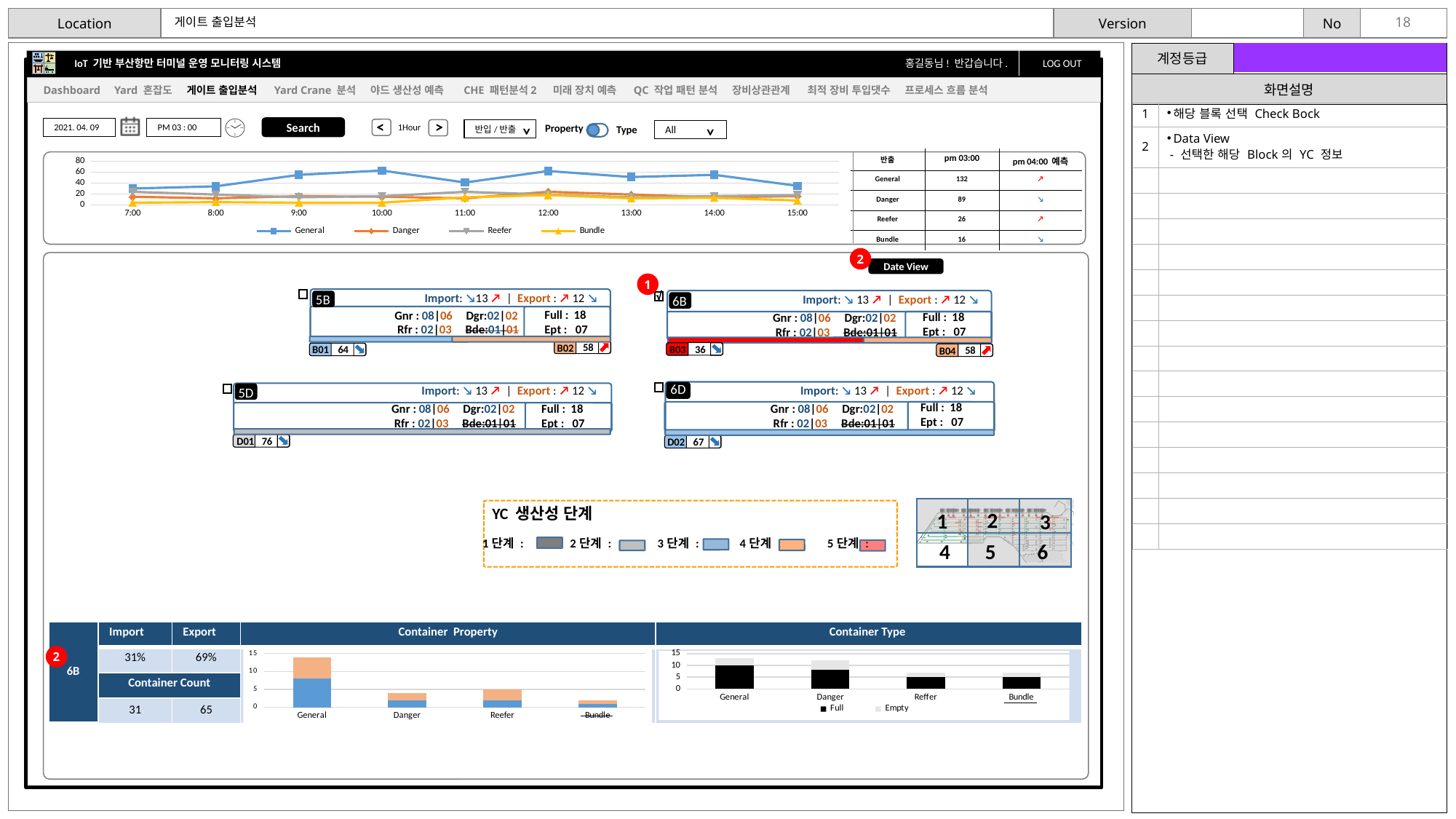
In the Container Property chart, which category has the tallest bar? General How many time points are plotted along the x axis of the top line chart? 9 What kind of chart is the top chart showing values from 7:00 to 15:00? line chart In the Container Property chart, which category has the shortest bar? Bundle In the Container Type chart, which category has the tallest bar? General In the top line chart, is the value for General at 7:00 greater or less than 40? less In the Container Property chart, is the total for General greater or less than 10? greater How many series does the legend of the Container Type chart list? 2 What kind of chart is the Container Property chart? bar chart In the top line chart, is the value for General at 10:00 greater or less than 40? greater In the top line chart, which series has the highest values across the time points? General How many series does the legend of the top line chart list? 4